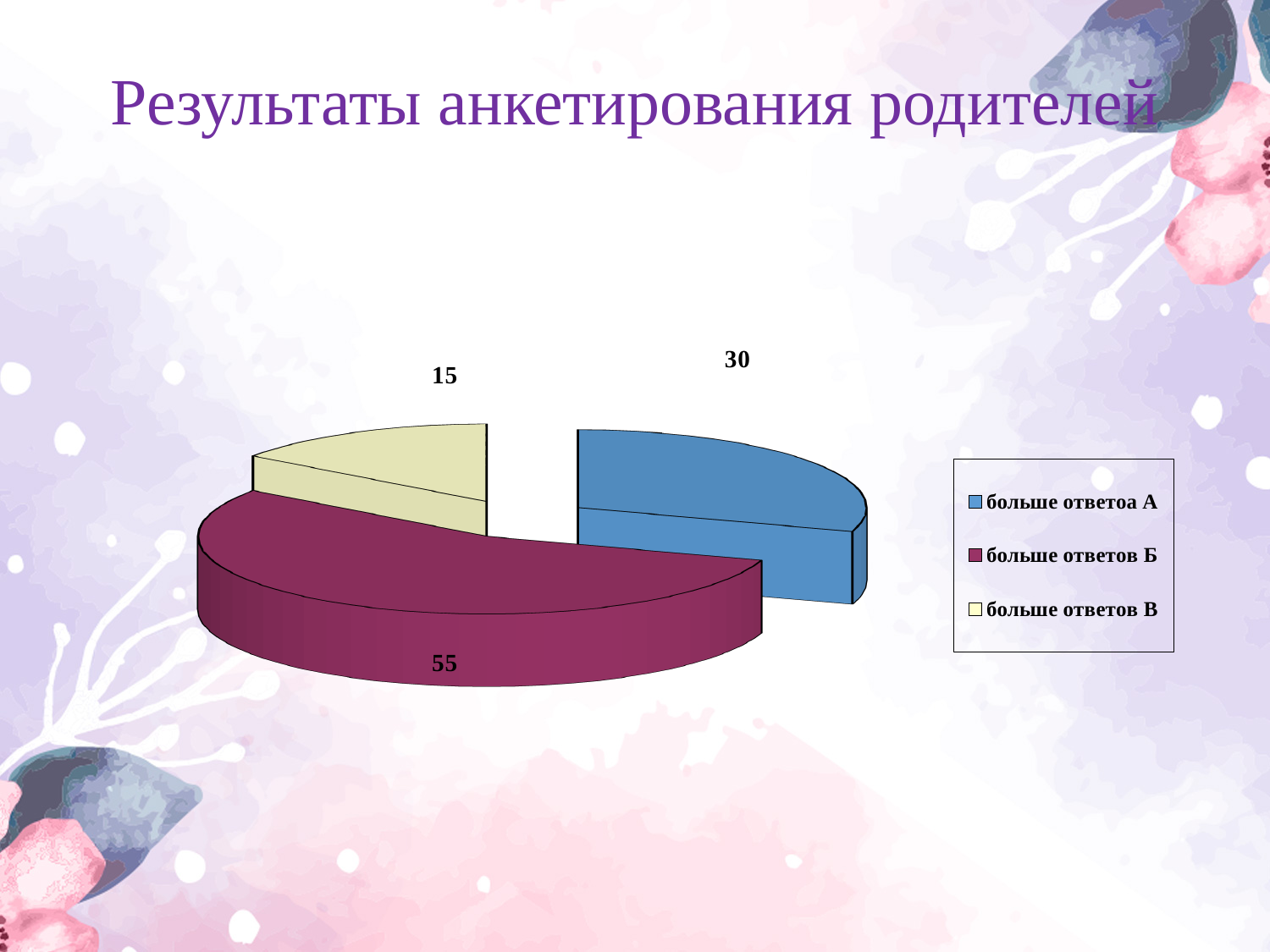
What is the value for "больше ответов В"? 15 Which category has the largest slice of the pie? больше ответов Б Which category has the smallest slice of the pie? больше ответов В What is the value for "больше ответов Б"? 55 What kind of chart is shown on the slide? pie chart What is the difference between the values for "больше ответоа А" and "больше ответов В"? 15 What is the value for "больше ответоа А"? 30 Which is larger, the value for "больше ответоа А" or the value for "больше ответов В"? больше ответоа А How many slices does the pie chart have? 3 What is the difference between the values for "больше ответов Б" and "больше ответоа А"? 25 What is the title of the slide containing the chart? Результаты анкетирования родителей What share of the pie does "больше ответов Б" represent? 55%